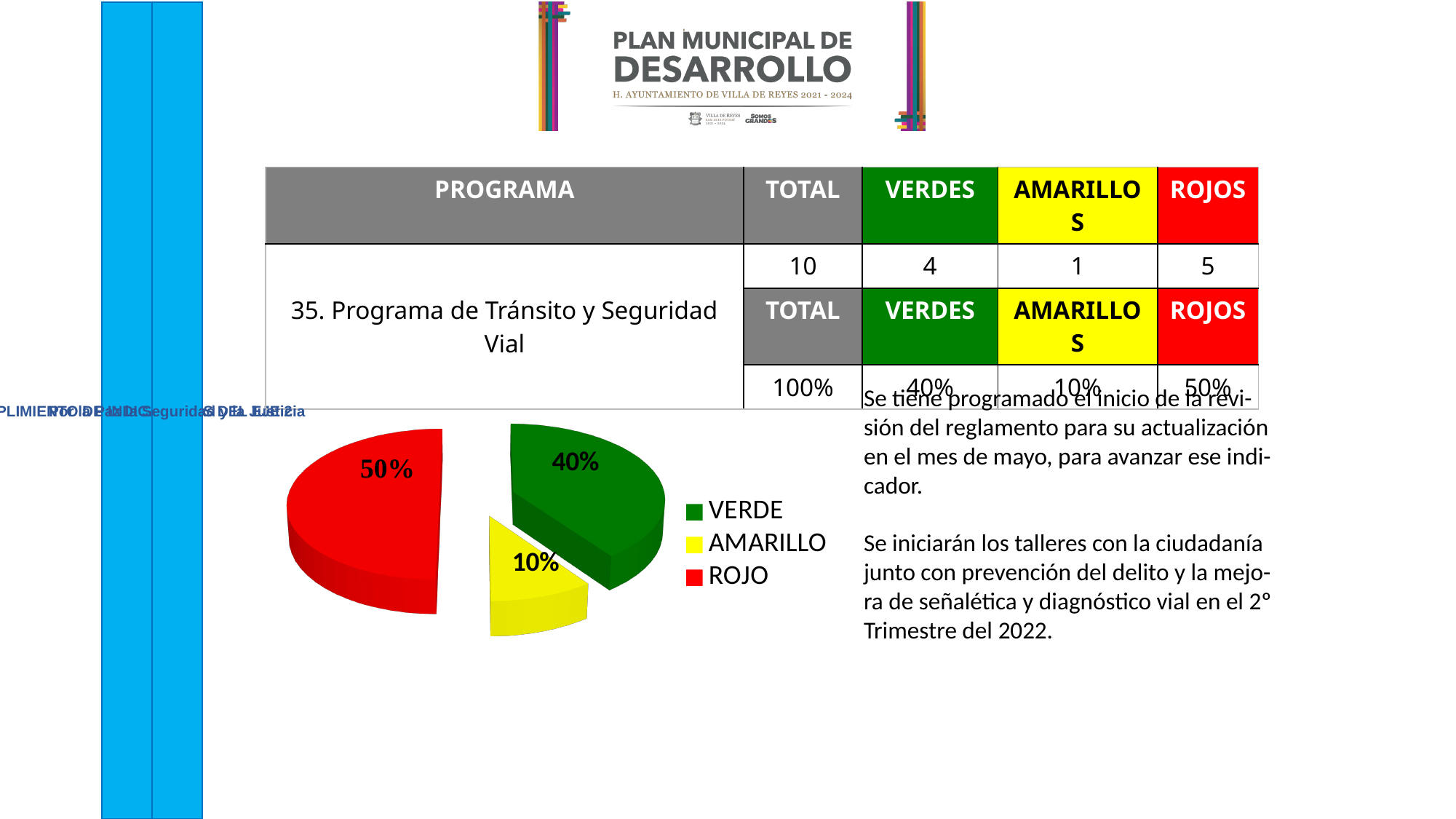
Which slice of the pie chart is the smallest? AMARILLO What share of the pie does ROJO represent? 50% Which slice of the pie chart is the largest? ROJO What kind of chart is shown on the slide? pie chart How many slices does the pie chart have? 3 What share of the pie does AMARILLO represent? 10% What is the difference in percentage points between the VERDE and AMARILLO slices? 30% What is the difference in percentage points between the ROJO and VERDE slices? 10% Which is larger, the VERDE slice or the AMARILLO slice? VERDE How many entries does the legend of the pie chart list? 3 What share of the pie does VERDE represent? 40% What colour is the slice labelled 50% in the pie chart? red